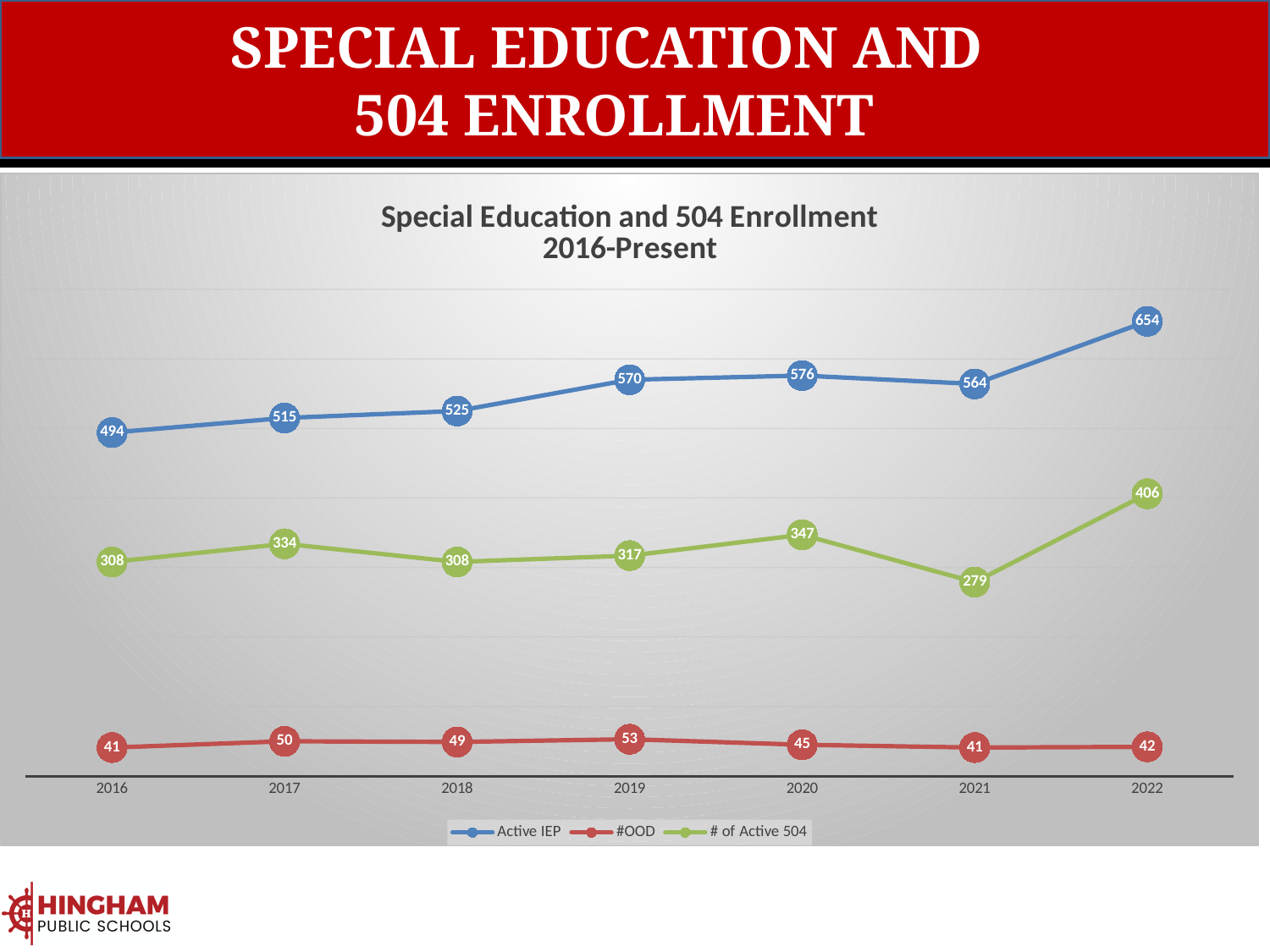
Does the Active IEP series rise or fall from 2016 to 2019? rise What is the difference between the Active IEP values for 2022 and 2021? 90 What kind of chart is shown on the slide? line chart In which year is the Active IEP value highest? 2022 In which year is the # of Active 504 value lowest? 2021 What is the Active IEP value for 2022? 654 What is the # of Active 504 value for 2021? 279 How many years are shown on the x axis? 7 What is the #OOD value for 2019? 53 What is the title of the chart? Special Education and 504 Enrollment 2016-Present How many series does the legend list? 3 Which is larger, the # of Active 504 value for 2017 or for 2018? 2017